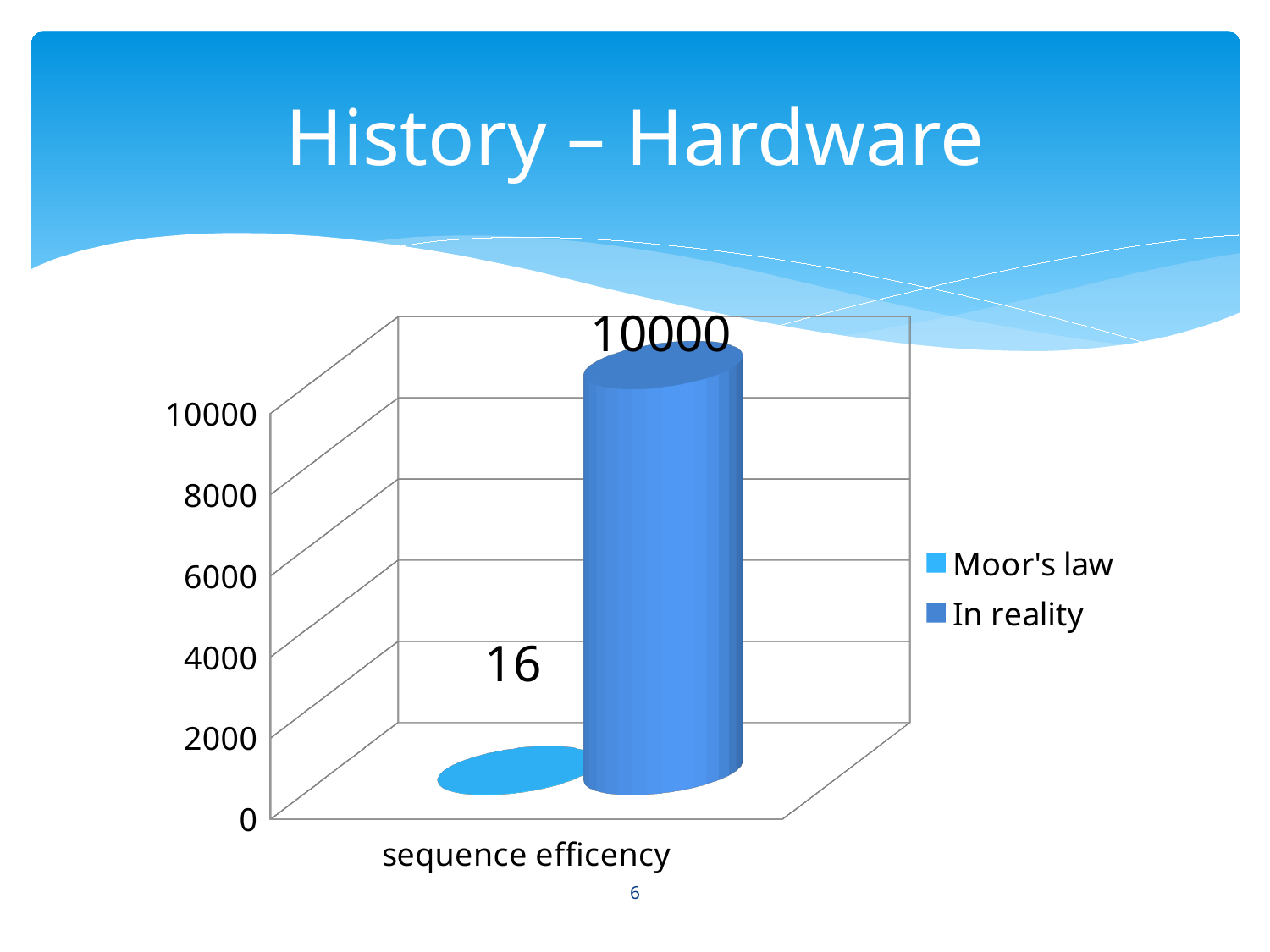
What is the difference between the In reality value and the Moor's law value? 9984 What is the value for Moor's law in the chart? 16 Is the value for Moor's law greater or less than 2000? less How many categories are shown on the x axis? 1 What kind of chart is shown on the slide? bar chart Which series has the lower value in the chart? Moor's law How many series does the legend list? 2 What is the category label shown on the x axis? sequence efficency What is the value for In reality in the chart? 10000 Is the value for Moor's law larger or smaller than the value for In reality? smaller Is the value for In reality greater or less than 8000? greater Which series has the higher value, Moor's law or In reality? In reality